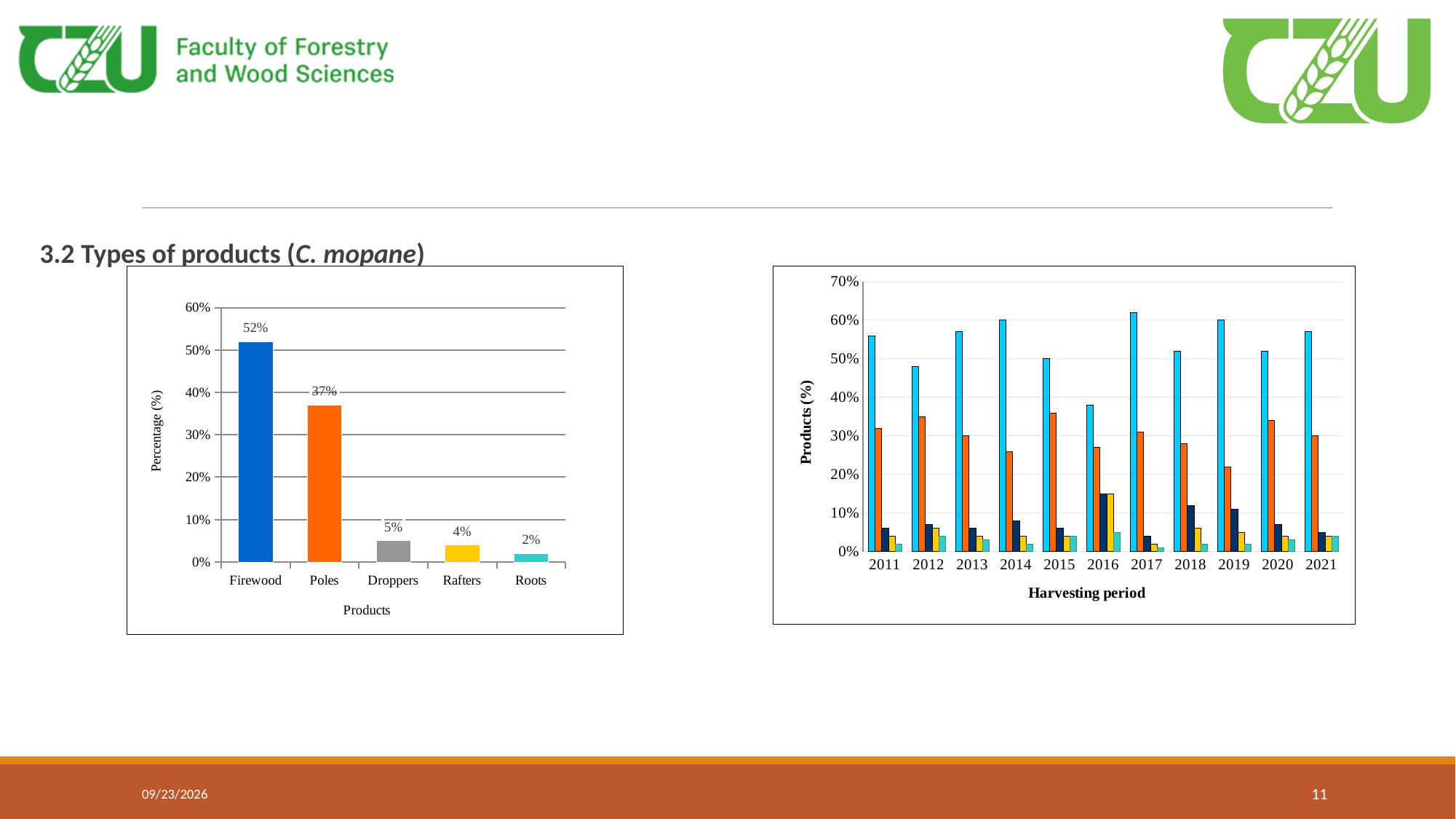
In the left chart, which product has the lowest percentage? Roots What kind of chart is the right chart? Bar chart In the left chart, which product has the highest percentage? Firewood How many product categories are shown in the left chart? 5 In the left chart, what is the value for Poles? 37% In the left chart, what is the difference between the values for Firewood and Poles? 15% In the right chart, is the tallest bar for 2017 greater or less than 60%? greater In the left chart, what is the value for Firewood? 52% In the left chart, which is larger, the value for Droppers or the value for Rafters? Droppers In the left chart, what is the value for Droppers? 5% How many harvesting periods (years) are shown on the x axis of the right chart? 11 In the left chart, what is the value for Roots? 2%